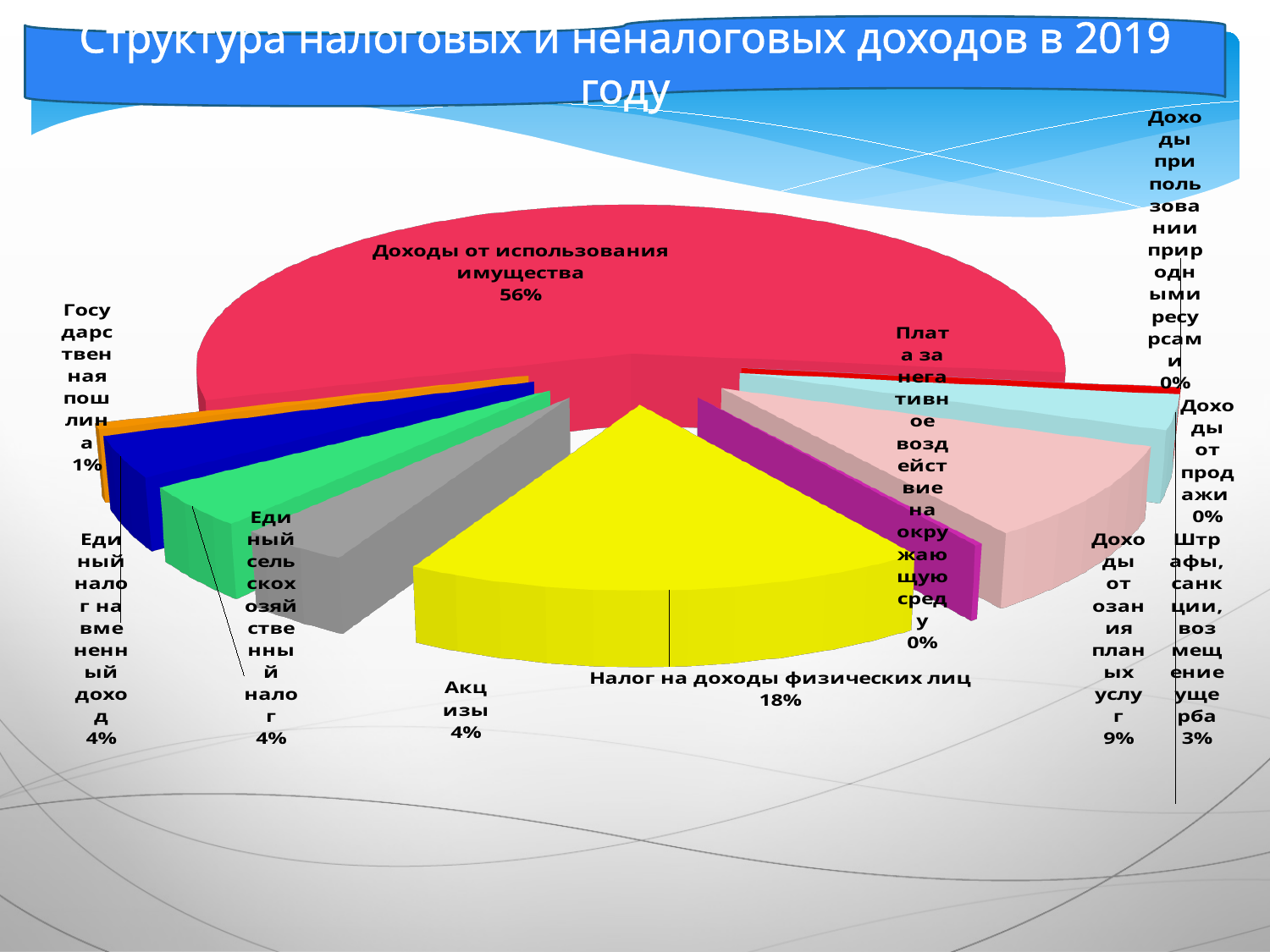
What share of the pie is "Доходы от использования имущества"? 56% What is the title of the chart? Структура налоговых и неналоговых доходов в 2019 году Which is larger: the share for "Доходы от оказания платных услуг" or the share for "Акцизы"? Доходы от оказания платных услуг What is the difference in percentage points between "Доходы от использования имущества" and "Налог на доходы физических лиц"? 38 What kind of chart is shown on the slide? Pie chart How many categories (slices) are labelled on the pie chart? 11 What share of the pie is "Налог на доходы физических лиц"? 18% Which category has the largest share of the pie? Доходы от использования имущества What colour is the slice for "Налог на доходы физических лиц"? Yellow What percentage is shown for "Государственная пошлина"? 1% What percentage is shown for "Доходы от оказания платных услуг"? 9% What percentage is shown for "Штрафы, санкции, возмещение ущерба"? 3%